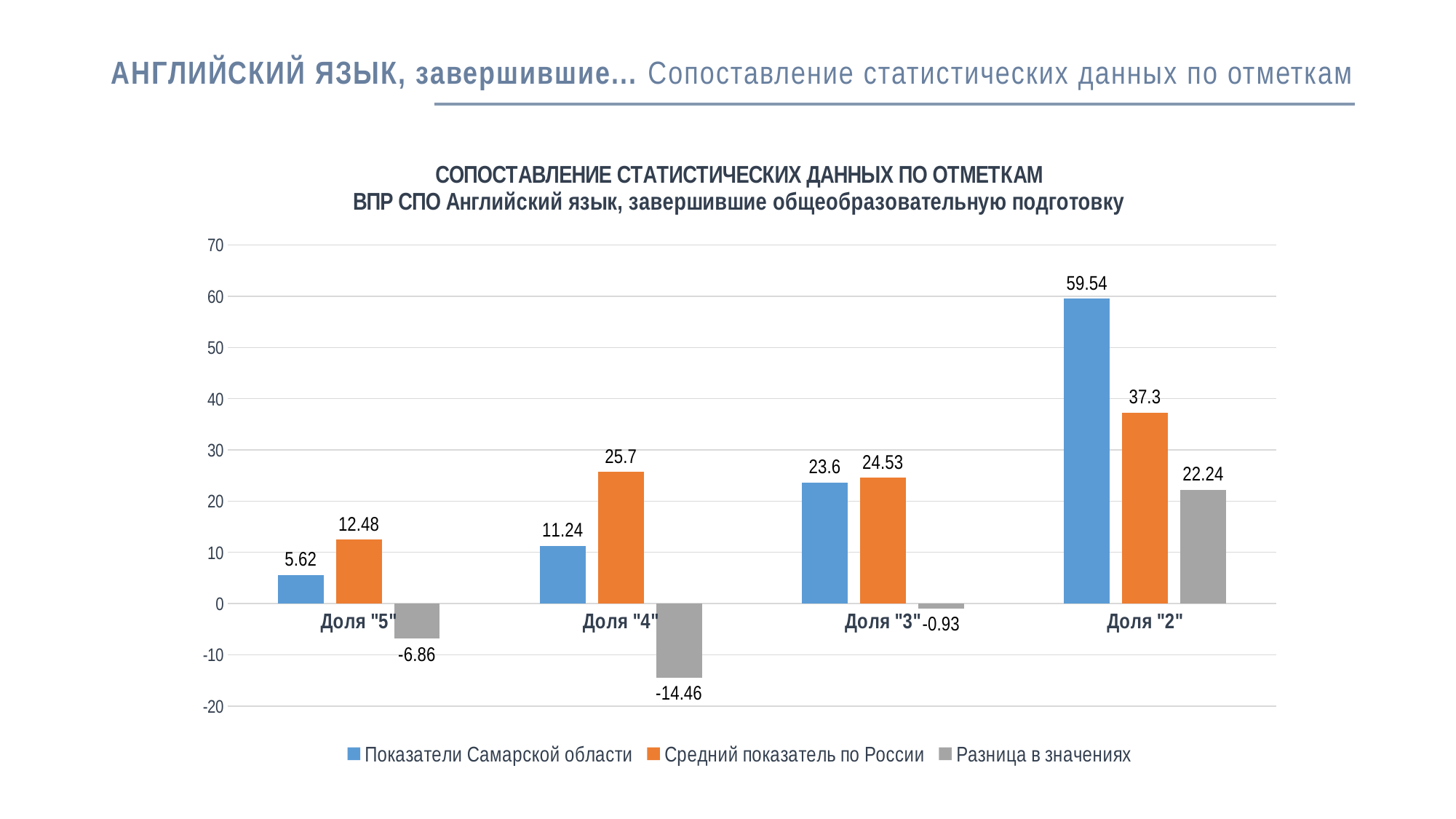
How many series does the legend list? 3 Which category has the lowest value for "Средний показатель по России"? Доля "5" What is the value of "Показатели Самарской области" for Доля "3"? 23.6 Is the value of "Средний показатель по России" for Доля "2" greater or less than 40? less What is the value of "Разница в значениях" for Доля "5"? -6.86 How many categories are shown on the x axis? 4 What is the value of "Показатели Самарской области" for Доля "2"? 59.54 Which is larger for Доля "2": "Показатели Самарской области" or "Средний показатель по России"? Показатели Самарской области What is the difference between "Средний показатель по России" and "Показатели Самарской области" for Доля "5"? 6.86 What kind of chart is shown on the slide? bar chart Which category has the highest value for "Показатели Самарской области"? Доля "2" What is the value of "Средний показатель по России" for Доля "4"? 25.7